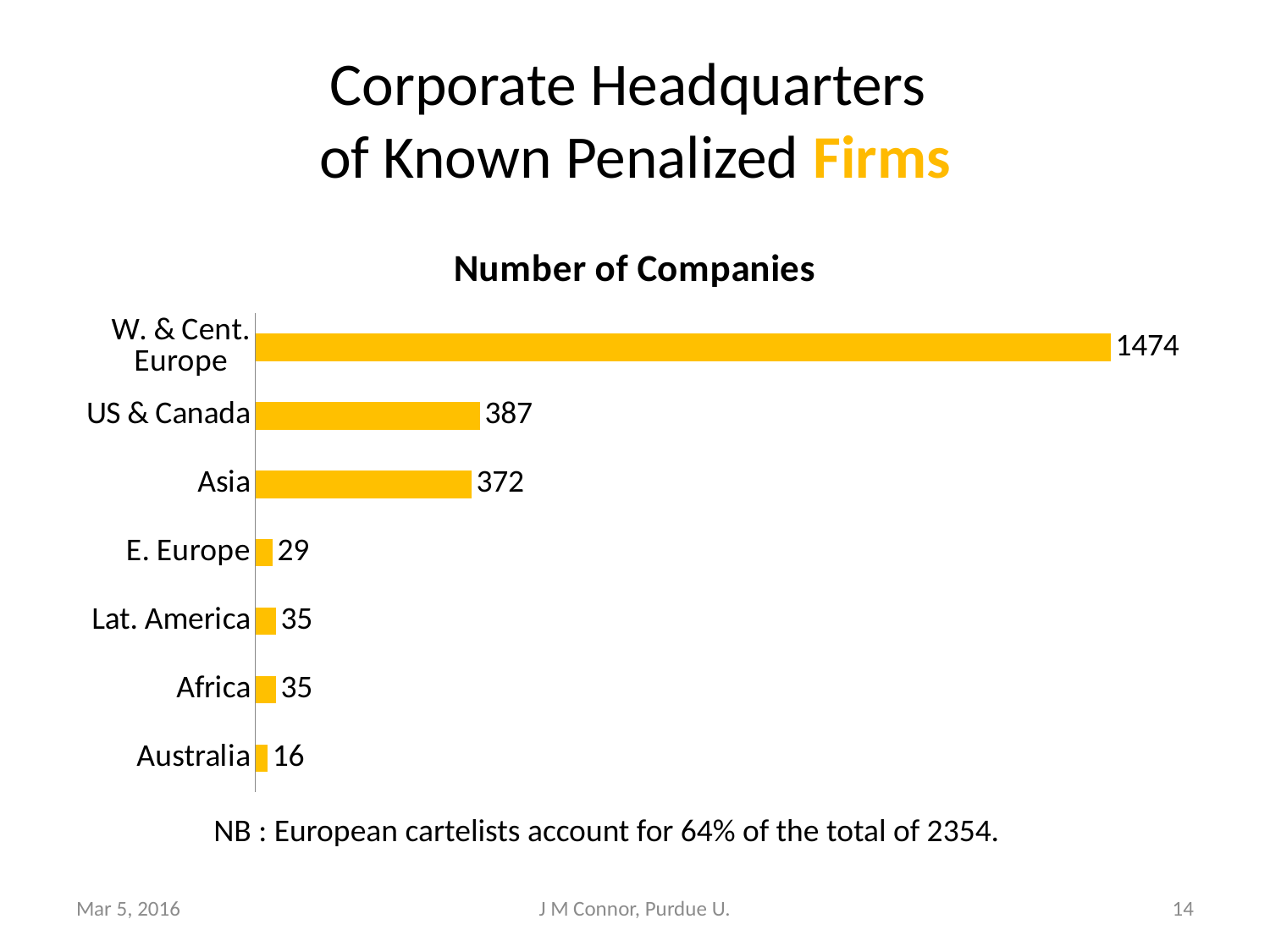
What is the number of companies for Asia? 372 What is the number of companies for Australia? 16 What kind of chart is shown on the slide? Bar chart Which region has the lowest number of companies? Australia Which region has the highest number of companies? W. & Cent. Europe What is the difference between the number of companies for W. & Cent. Europe and US & Canada? 1087 What is the number of companies for E. Europe? 29 What is the number of companies for W. & Cent. Europe? 1474 Which has more companies, Lat. America or E. Europe? Lat. America What is the title of the chart? Number of Companies What is the difference between the number of companies for US & Canada and Asia? 15 How many regions are shown in the chart? 7